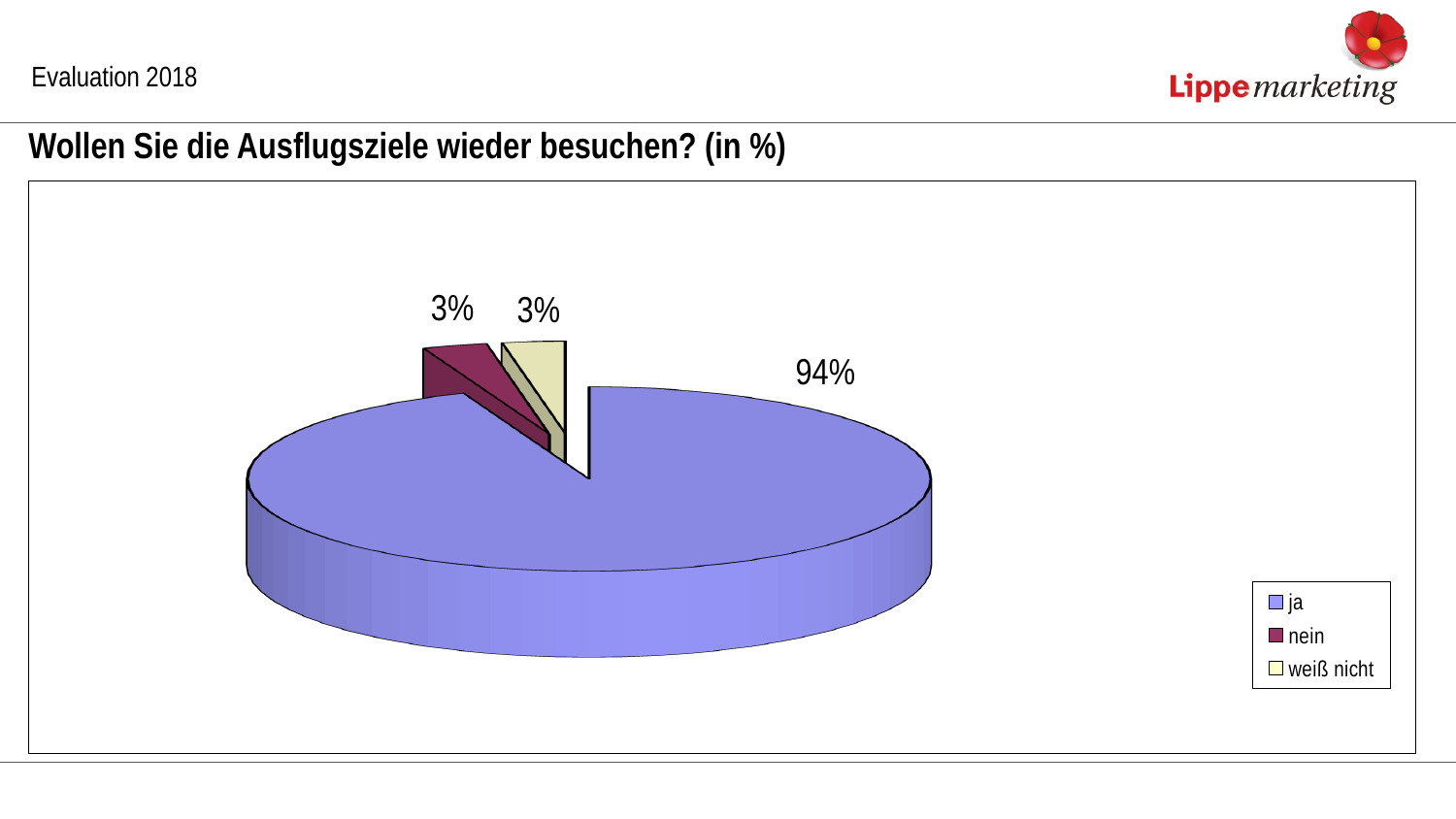
Which is larger, the share for "ja" or the share for "weiß nicht"? ja Which category has the largest share of the pie? ja What kind of chart is shown on the slide? Pie chart What is the title of the chart? Wollen Sie die Ausflugsziele wieder besuchen? (in %) What share of the pie does the "ja" slice represent? 94% What percentage of respondents answered "ja"? 94% Which legend entry is shown in dark red? nein What percentage of respondents answered "weiß nicht"? 3% What is the difference in percentage points between "ja" and "nein"? 91 What percentage of respondents answered "nein"? 3% How many slices does the pie chart have? 3 How many entries does the legend list? 3